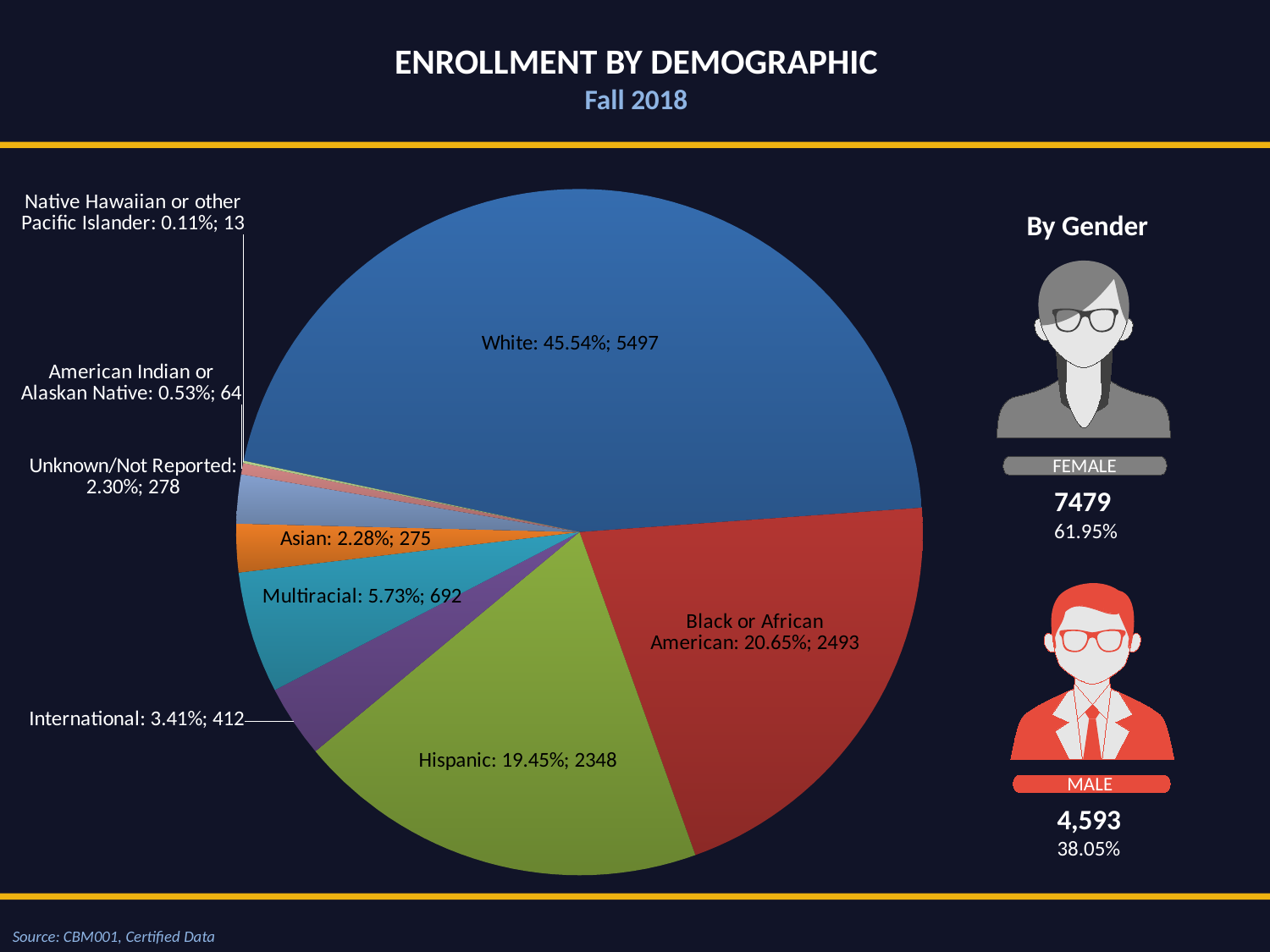
What percentage of enrollment is American Indian or Alaskan Native? 0.53% Which category has the largest share of the pie chart? White What share of the pie does the White category represent? 45.54% What is the title of the slide containing the pie chart? ENROLLMENT BY DEMOGRAPHIC Which is larger, the Multiracial slice or the International slice? Multiracial What kind of chart is shown on the slide? pie chart What is the enrollment count for Hispanic students in the pie chart? 2348 What is the difference in enrollment count between Black or African American and Hispanic students? 145 What percentage of enrollment is Black or African American? 20.65% Which category has the smallest share of the pie chart? Native Hawaiian or other Pacific Islander How many categories does the pie chart show? 9 What is the enrollment count for Multiracial students? 692